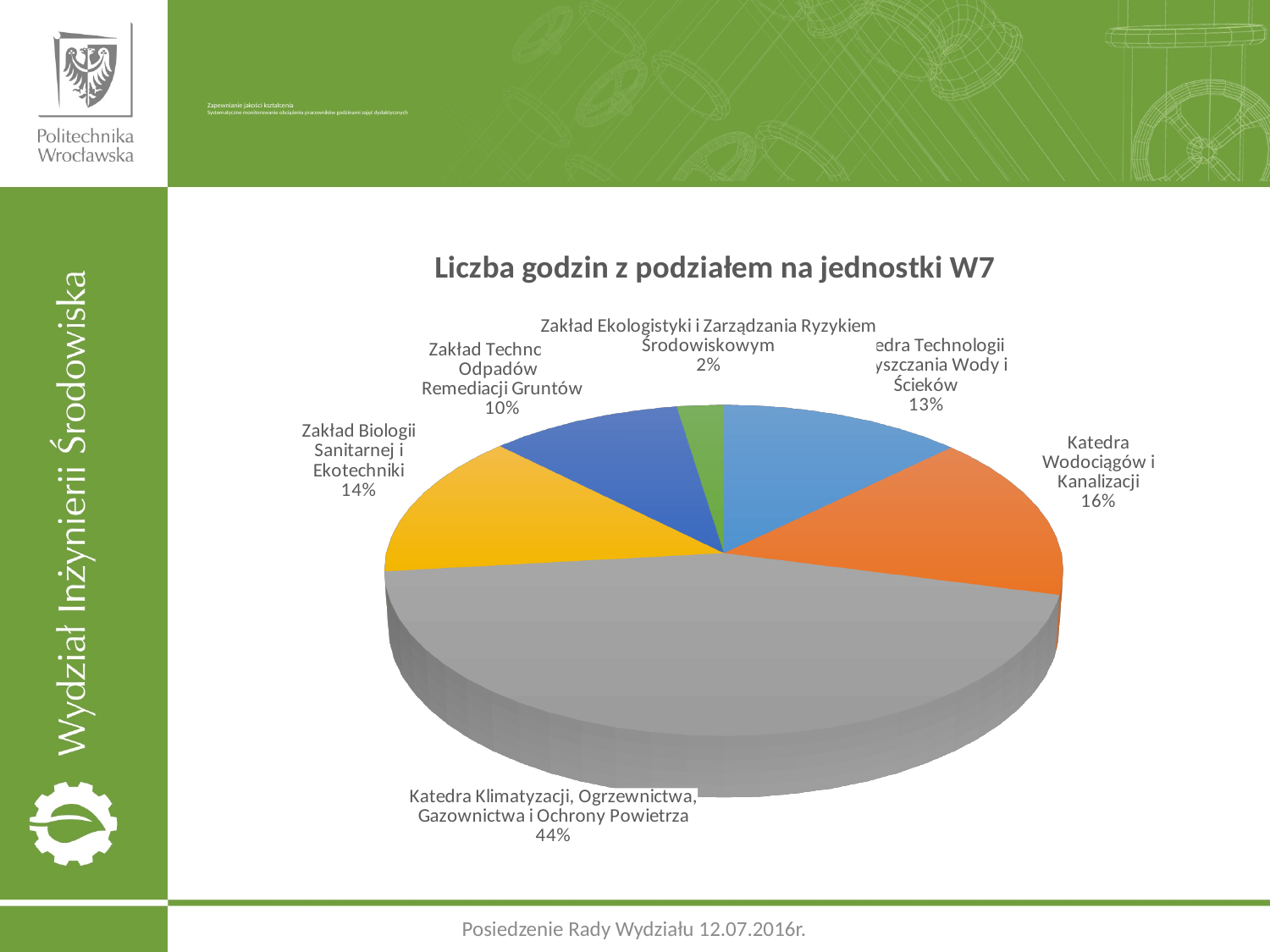
What is the difference in percentage points between the share of Katedra Klimatyzacji, Ogrzewnictwa, Gazownictwa i Ochrony Powietrza and Katedra Wodociągów i Kanalizacji? 28 percentage points Which unit has the largest share of the pie? Katedra Klimatyzacji, Ogrzewnictwa, Gazownictwa i Ochrony Powietrza What share of the pie does Katedra Wodociągów i Kanalizacji have? 16% What type of chart is shown on the slide? Pie chart What share of the pie does Katedra Klimatyzacji, Ogrzewnictwa, Gazownictwa i Ochrony Powietrza have? 44% What share of the pie does Zakład Ekologistyki i Zarządzania Ryzykiem Środowiskowym have? 2% Which has a larger share: Katedra Wodociągów i Kanalizacji or Zakład Biologii Sanitarnej i Ekotechniki? Katedra Wodociągów i Kanalizacji What is the title of the chart? Liczba godzin z podziałem na jednostki W7 Which unit has the smallest share of the pie? Zakład Ekologistyki i Zarządzania Ryzykiem Środowiskowym What colour is the slice for Katedra Klimatyzacji, Ogrzewnictwa, Gazownictwa i Ochrony Powietrza? Grey How many slices does the pie chart have? 6